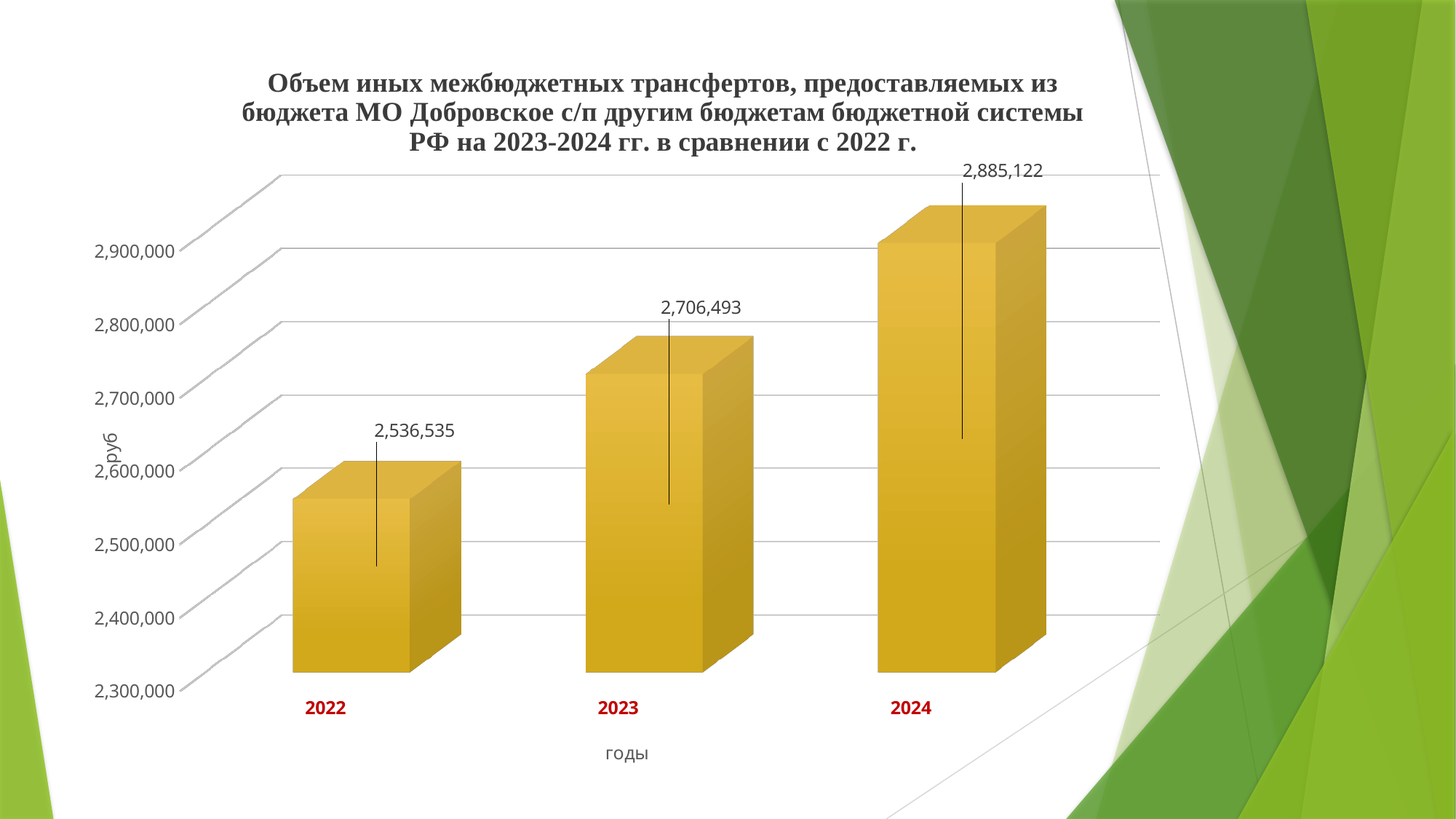
Do the values rise or fall from 2022 to 2024? rise Which year has the highest value? 2024 What kind of chart is shown on the slide? bar chart How many years are shown on the chart? 3 What is the difference between the values for 2023 and 2022? 169,958 Which year has the lowest value? 2022 What is the value for 2022? 2,536,535 What is the difference between the values for 2024 and 2023? 178,629 Which is larger, the value for 2023 or the value for 2024? 2024 Is the value for 2022 greater or less than 2,500,000? greater What is the value for 2024? 2,885,122 What is the value for 2023? 2,706,493